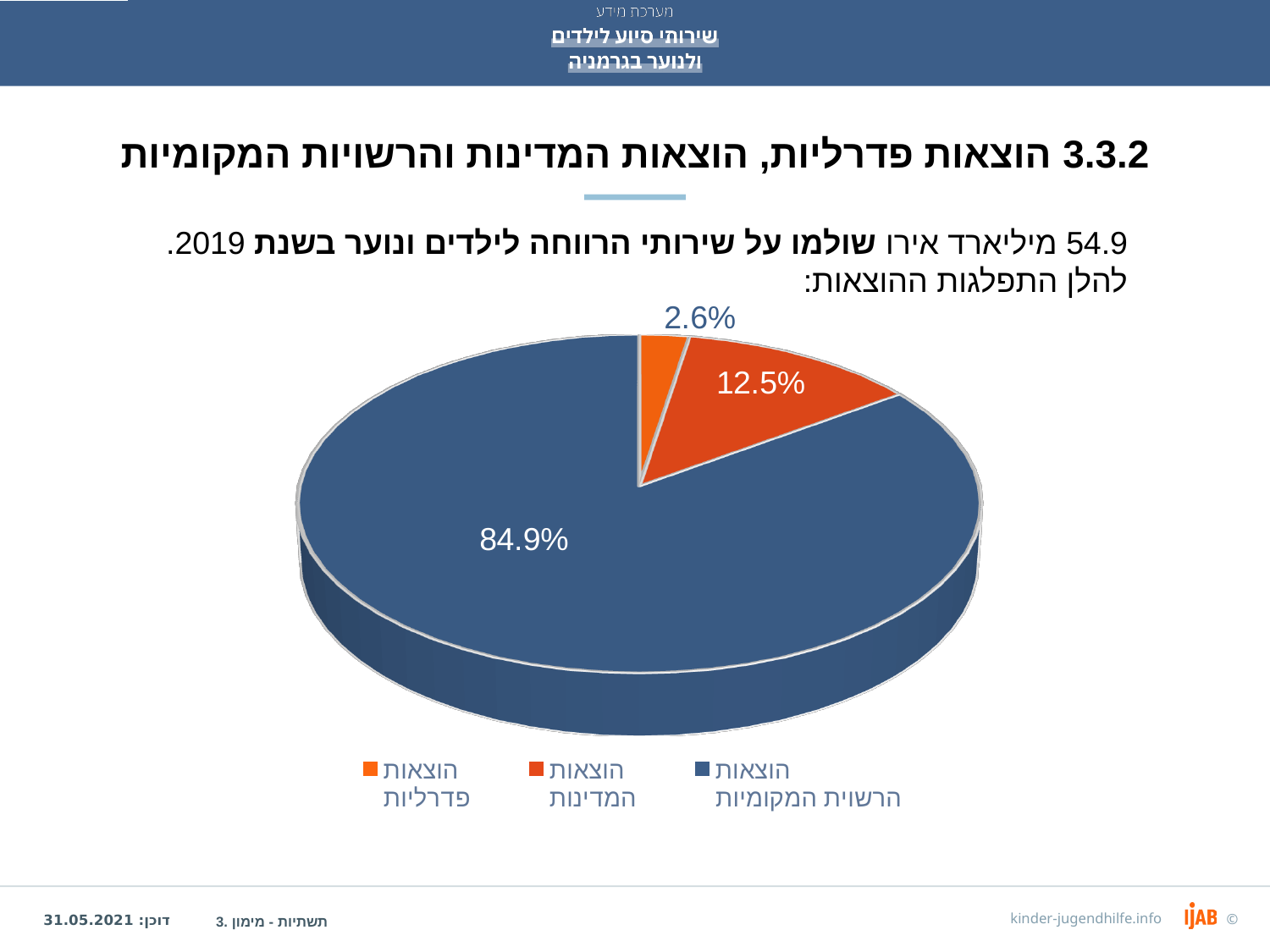
What colour is the slice for הוצאות הרשוית המקומיות? Blue How many entries does the legend list? 3 What share of the pie is labelled for הוצאות הרשוית המקומיות? 84.9% What share of the pie is labelled for הוצאות המדינות? 12.5% Which category has the smallest slice of the pie? הוצאות פדרליות Which category has the largest slice of the pie? הוצאות הרשוית המקומיות What is the difference in percentage points between the slices for הוצאות הרשוית המקומיות and הוצאות המדינות? 72.4 Which is larger, the slice for הוצאות המדינות or the slice for הוצאות פדרליות? הוצאות המדינות How many slices does the pie chart have? 3 What share of the pie is labelled for הוצאות פדרליות? 2.6% What kind of chart is shown on the slide? Pie chart What is the difference in percentage points between the slices for הוצאות המדינות and הוצאות פדרליות? 9.9